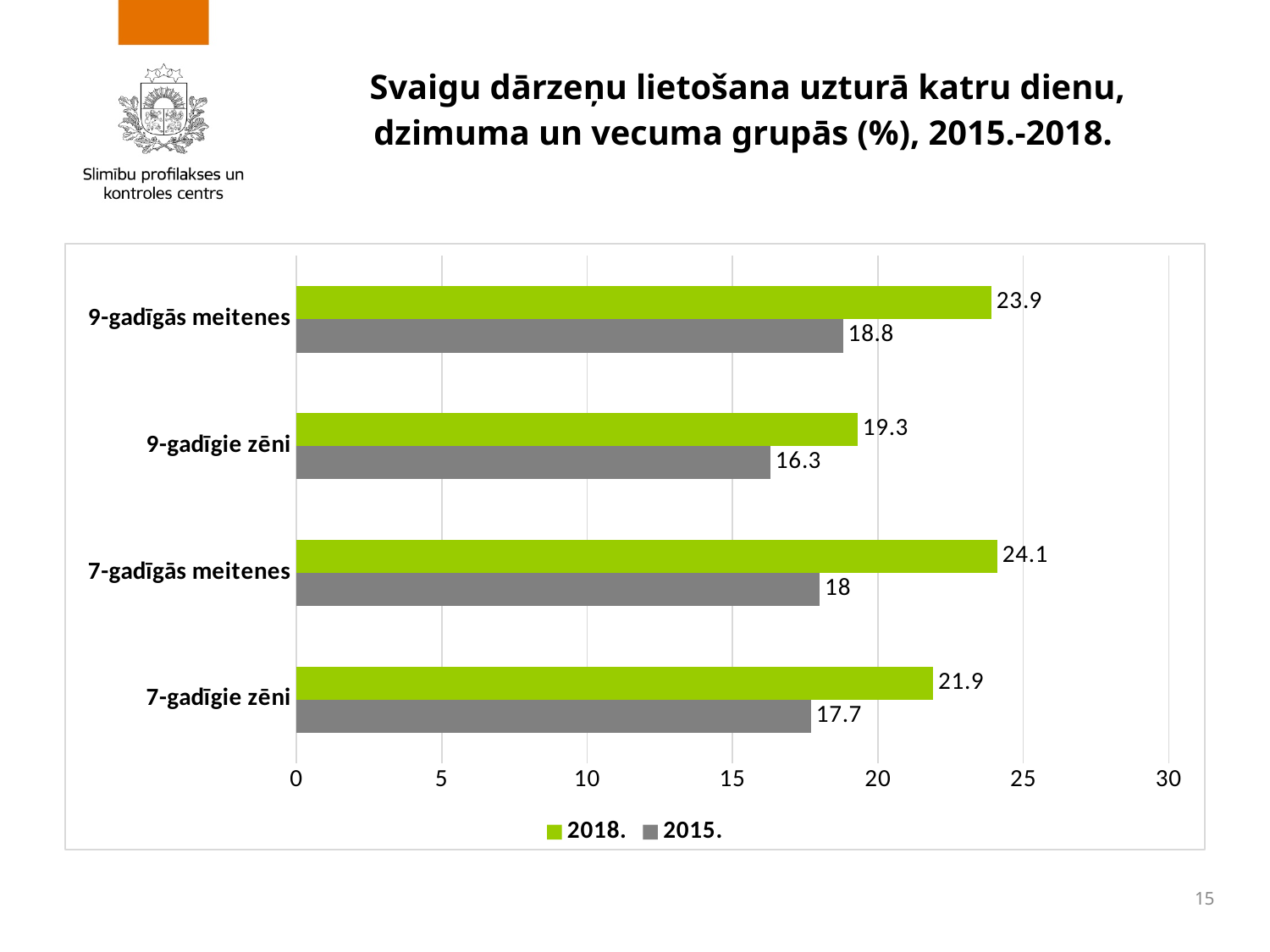
How many categories are shown on the chart? 4 What is the 2018. value for 9-gadīgās meitenes? 23.9 What is the difference between the 2018. and 2015. values for 7-gadīgās meitenes? 6.1 Which category has the lowest 2015. value? 9-gadīgie zēni What is the difference between the 2018. values for 9-gadīgās meitenes and 9-gadīgie zēni? 4.6 What kind of chart is shown on the slide? bar chart Which is larger: the 2018. value for 7-gadīgie zēni or the 2018. value for 9-gadīgie zēni? 7-gadīgie zēni How many series does the legend list? 2 What is the 2015. value for 9-gadīgie zēni? 16.3 What is the 2015. value for 7-gadīgie zēni? 17.7 Is the 2015. value for 9-gadīgās meitenes greater or less than 20? less Which category has the highest 2018. value? 7-gadīgās meitenes